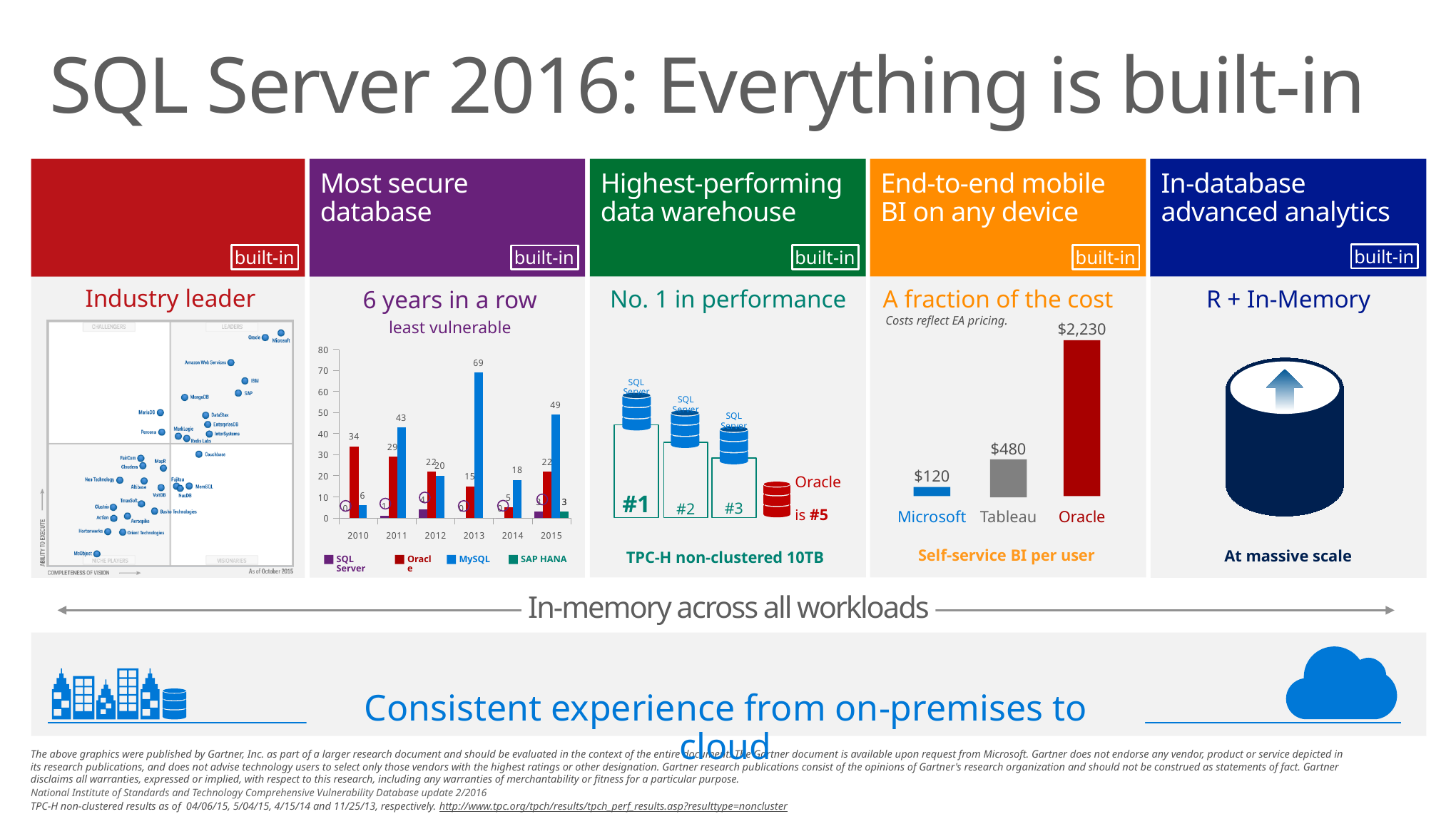
In the 'Self-service BI per user' chart, what is the cost per user for Oracle? $2,230 In the 'least vulnerable' bar chart under 'Most secure database', in which year does MySQL have its highest value? 2013 In the 'least vulnerable' bar chart under 'Most secure database', what is the difference between MySQL and Oracle in 2015? 27 In the 'least vulnerable' bar chart under 'Most secure database', what is the value for MySQL in 2013? 69 In the 'Self-service BI per user' chart, how much more does Oracle cost per user than Tableau? $1,750 How many vendors are shown in the 'Self-service BI per user' chart? 3 How many series does the legend of the 'least vulnerable' bar chart under 'Most secure database' list? 4 In the 'least vulnerable' bar chart under 'Most secure database', which is larger in 2011, Oracle or MySQL? MySQL In the 'Self-service BI per user' chart, what is the cost per user for Microsoft? $120 What kind of chart is shown under 'Most secure database'? Bar chart In the 'least vulnerable' bar chart under 'Most secure database', what is the value for Oracle in 2010? 34 In the 'Self-service BI per user' chart, which vendor has the lowest cost per user? Microsoft